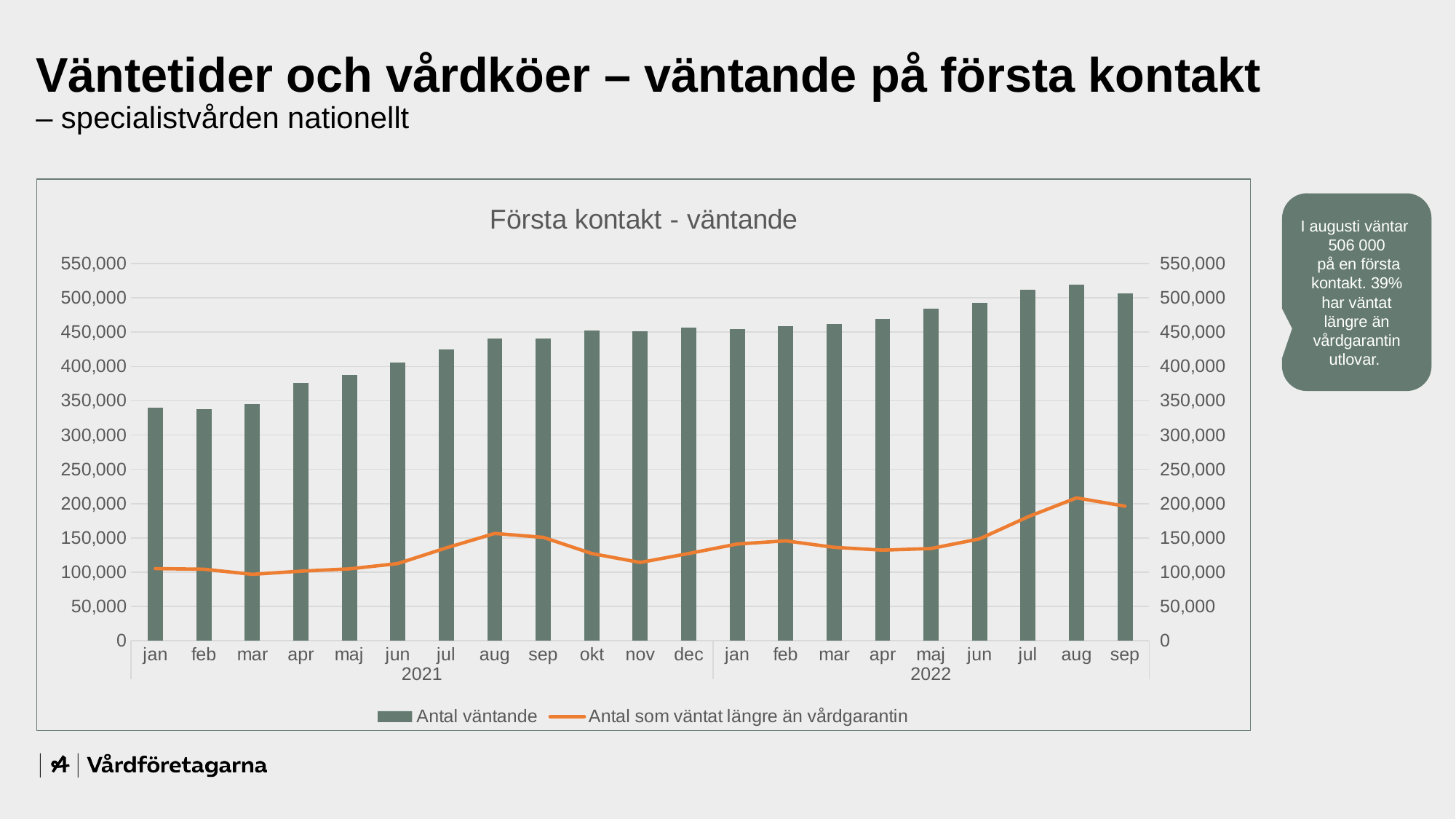
How many series does the legend of the chart list? 2 Is the 'Antal som väntat längre än vårdgarantin' value for jul 2022 greater or less than 150,000? greater Do the 'Antal väntande' bars generally rise or fall from jan 2021 to sep 2022? rise What kind of chart is shown on the slide? A bar chart combined with a line Which is larger, the 'Antal väntande' bar for jan 2021 or for aug 2022? aug 2022 Is the 'Antal väntande' bar for aug 2022 greater or less than 500,000? greater In which month is the 'Antal som väntat längre än vårdgarantin' line at its lowest? mar 2021 Is the 'Antal som väntat längre än vårdgarantin' value for nov 2021 greater or less than 150,000? less How many months are plotted along the x axis of the chart? 21 In which month is the 'Antal väntande' bar highest? aug 2022 In which month is the 'Antal som väntat längre än vårdgarantin' line at its highest? aug 2022